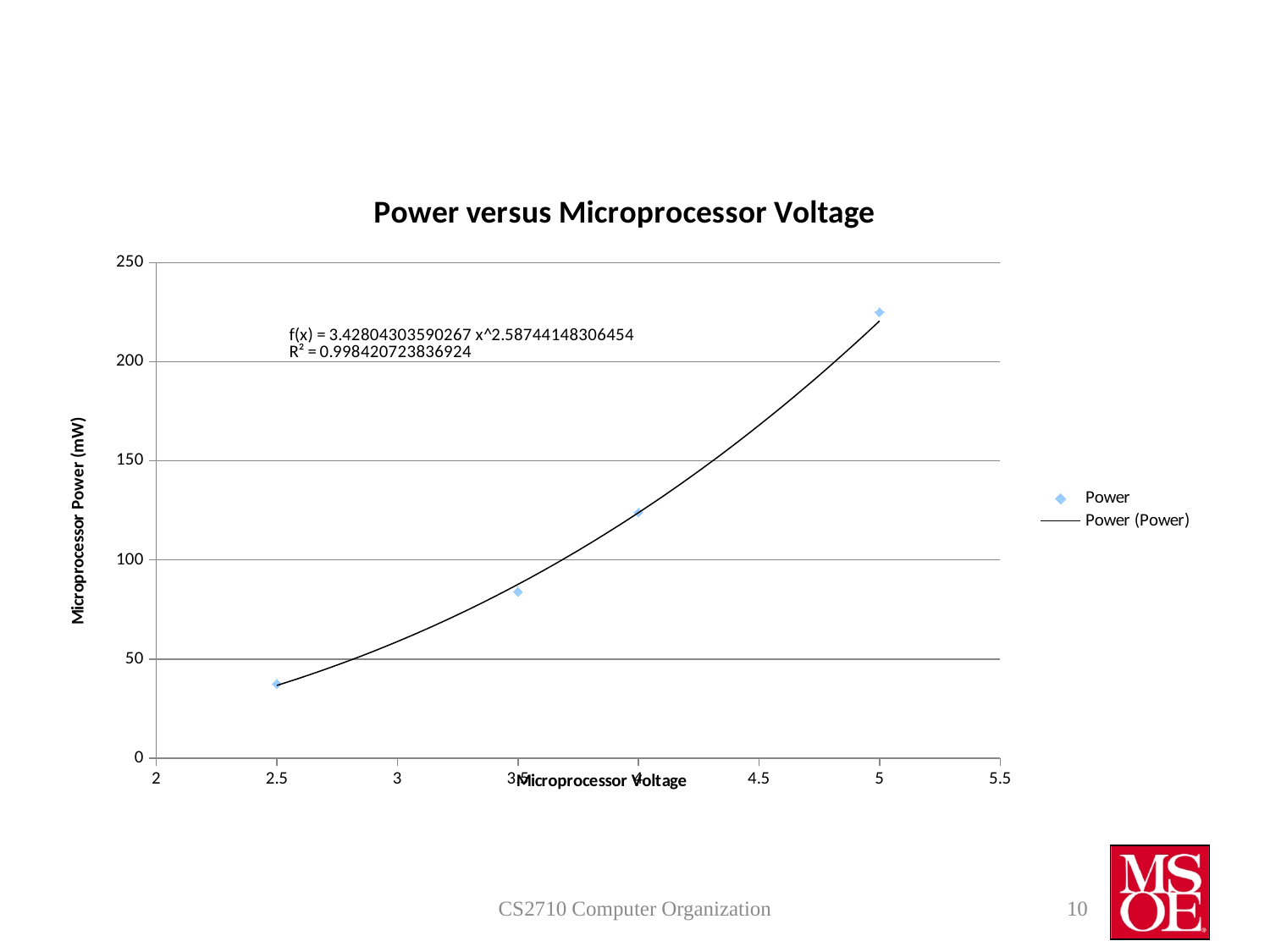
How many data points are plotted in the chart? 4 What kind of chart is shown on the slide? Scatter chart Do the plotted power values rise or fall as microprocessor voltage increases? Rise What R² value is printed for the trendline on the chart? 0.998420723836924 At which microprocessor voltage is the plotted power highest? 5 Is the power value at a voltage of 4 greater or less than 100 mW? greater How many entries does the chart legend list? 2 Is the power value at a voltage of 5 greater or less than 200 mW? greater Which has the larger plotted power: the point at voltage 3.5 or the point at voltage 4? 4 Is the power value at a voltage of 2.5 greater or less than 50 mW? less What is the title of the chart? Power versus Microprocessor Voltage At which microprocessor voltage is the plotted power lowest? 2.5